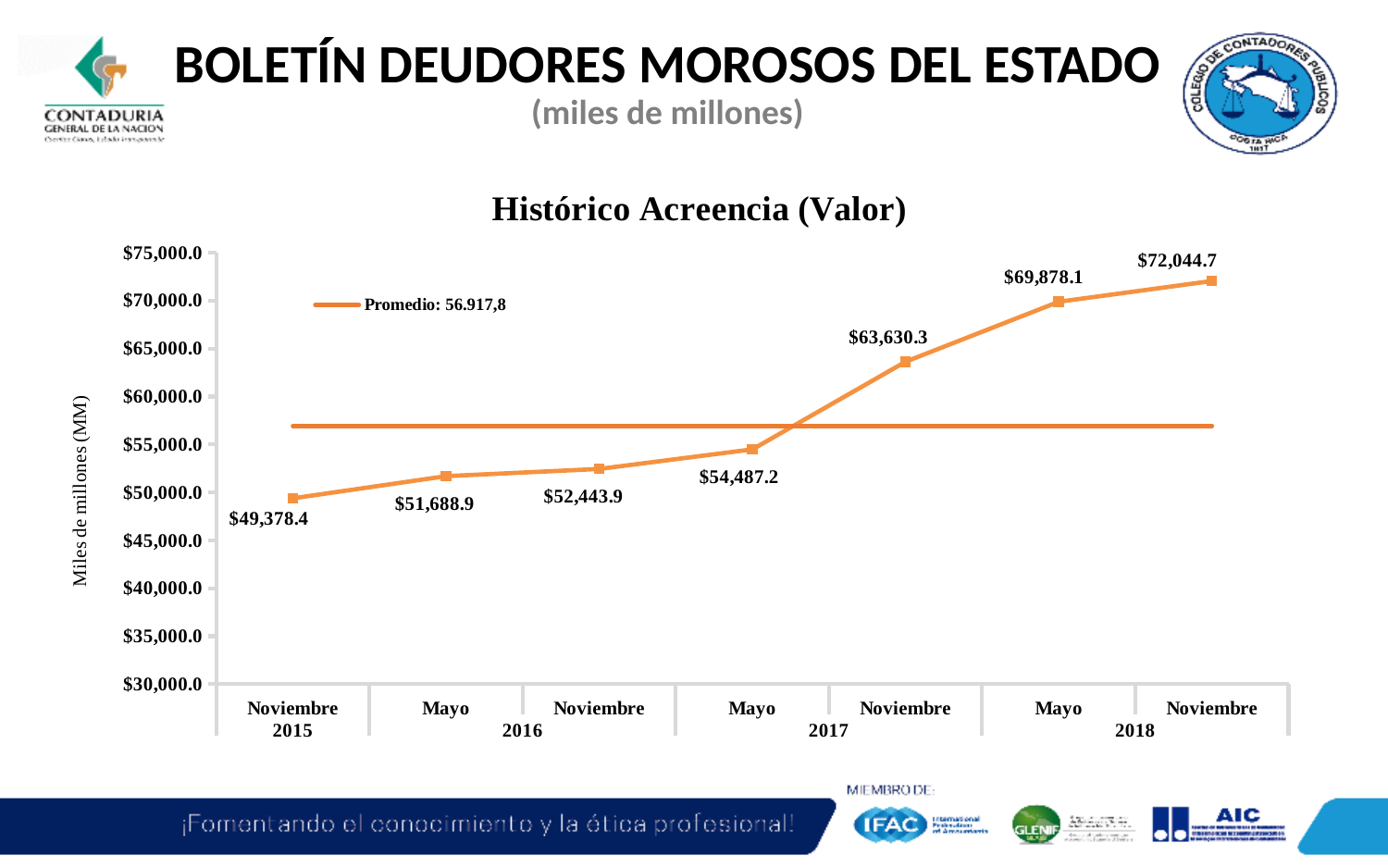
Is the value for Mayo 2016 in the Histórico Acreencia (Valor) chart greater or less than $55,000.0? less What kind of chart is the Histórico Acreencia (Valor) chart? line chart What is the difference between the values for Noviembre 2018 and Noviembre 2015 in the Histórico Acreencia (Valor) chart? $22,666.3 What is the difference between the values for Mayo 2018 and Noviembre 2017 in the Histórico Acreencia (Valor) chart? $6,247.8 Which period has the highest value in the Histórico Acreencia (Valor) chart? Noviembre 2018 How many data points are plotted on the line in the Histórico Acreencia (Valor) chart? 7 What is the value for Noviembre 2018 in the Histórico Acreencia (Valor) chart? $72,044.7 What is the Promedio (average) value shown in the legend of the Histórico Acreencia (Valor) chart? 56.917,8 Which is larger in the Histórico Acreencia (Valor) chart: the value for Noviembre 2017 or the value for Mayo 2017? Noviembre 2017 What is the value for Mayo 2017 in the Histórico Acreencia (Valor) chart? $54,487.2 Which period has the lowest value in the Histórico Acreencia (Valor) chart? Noviembre 2015 What is the value for Noviembre 2015 in the Histórico Acreencia (Valor) chart? $49,378.4